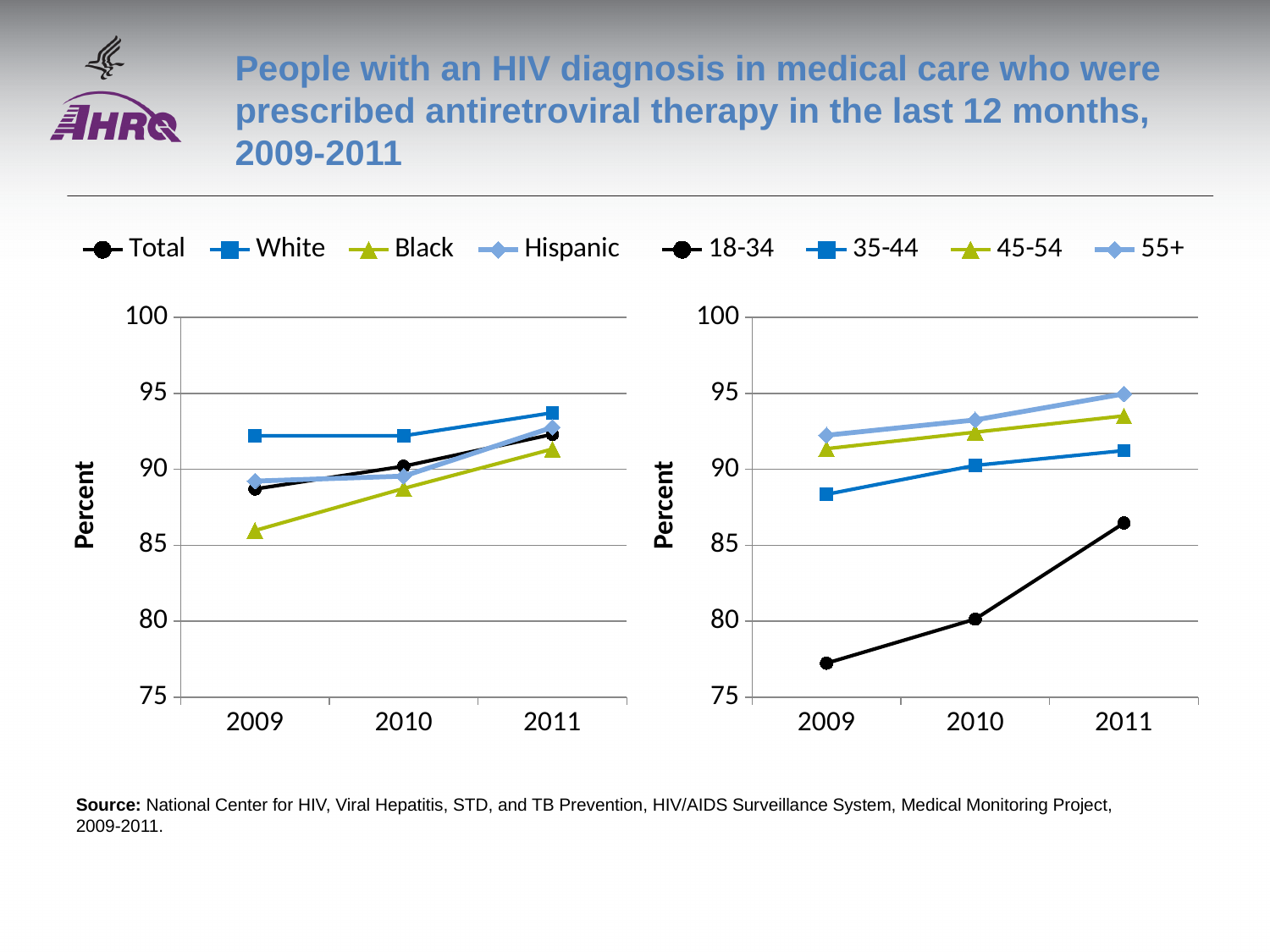
In the left chart, which group had the highest value in 2009? White How many years are shown on the x axis of the left chart? 3 In the right chart, which age group had the lowest value in every year? 18-34 In the left chart, is the value for Total in 2009 greater or less than 90? less In the left chart, is the value for Black in 2009 greater or less than 85? greater In the left chart, does the value for Black rise or fall from 2009 to 2011? rise In the left chart, which group had the lowest value in 2009? Black In the right chart, is the value for 18-34 in 2009 greater or less than 80? less How many series does the legend list for the right chart (age groups)? 4 In the right chart, which is larger in 2011, the value for 55+ or the value for 35-44? 55+ What kind of chart is the left chart (Total, White, Black, Hispanic)? line chart